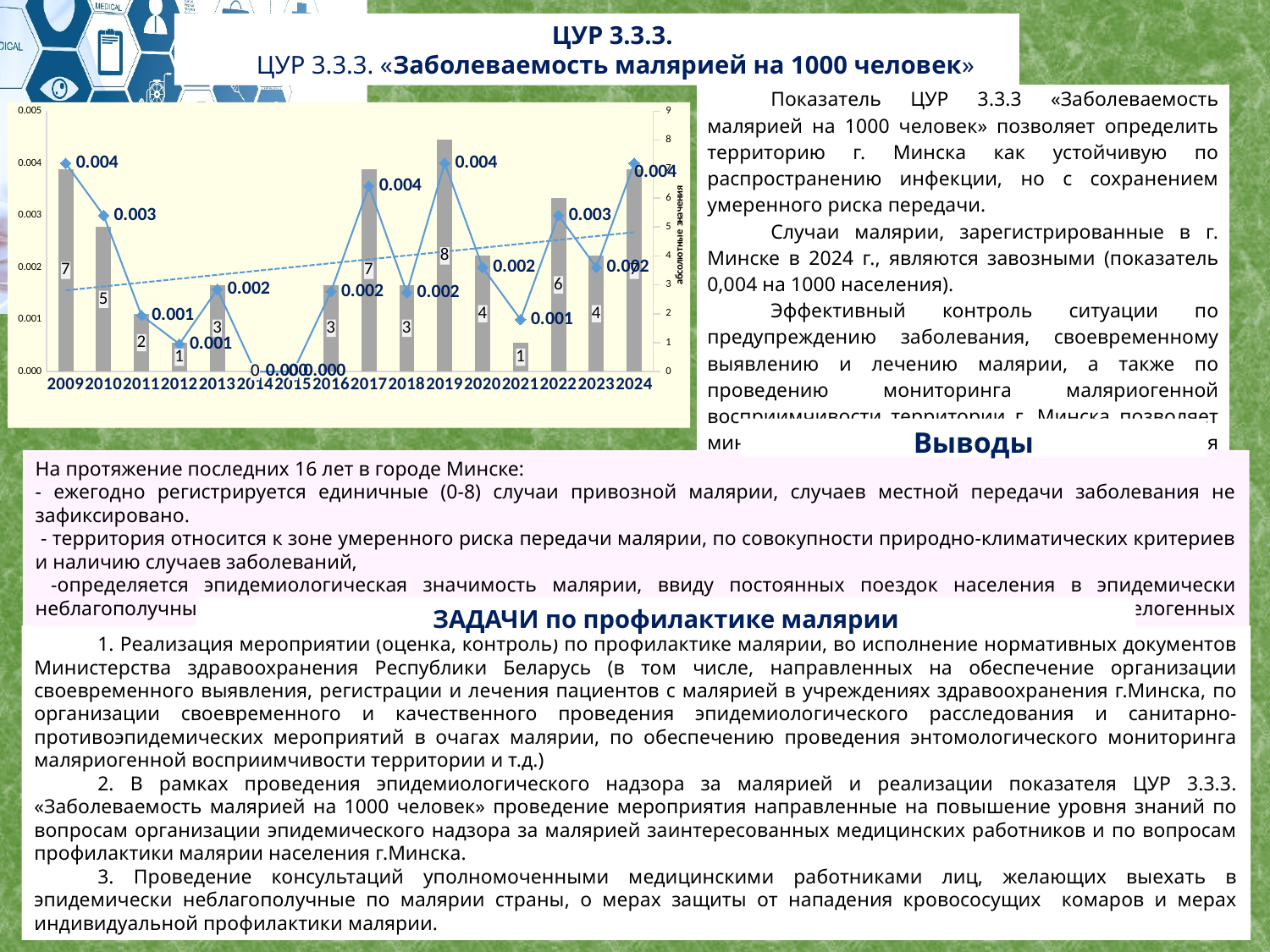
Is the bar value for 2009 greater or less than 6? greater What is the title of the chart on the slide? ЦУР 3.3.3. «Заболеваемость малярией на 1000 человек» What is the incidence per 1000 people shown on the line for 2010? 0.003 What is the difference between the bar values for 2019 and 2020? 4 Which year has the larger bar value, 2017 or 2018? 2017 Which years have a bar value of 0 (the lowest)? 2014 and 2015 What kind of chart is shown on the slide? Combined bar and line chart What is the incidence per 1000 people shown on the line for 2024? 0.004 What is the absolute number of malaria cases shown by the bar for 2019? 8 Which year has the highest bar (absolute number of cases)? 2019 How many years are shown on the x axis of the chart? 16 What is the absolute number of cases shown by the bar for 2022? 6